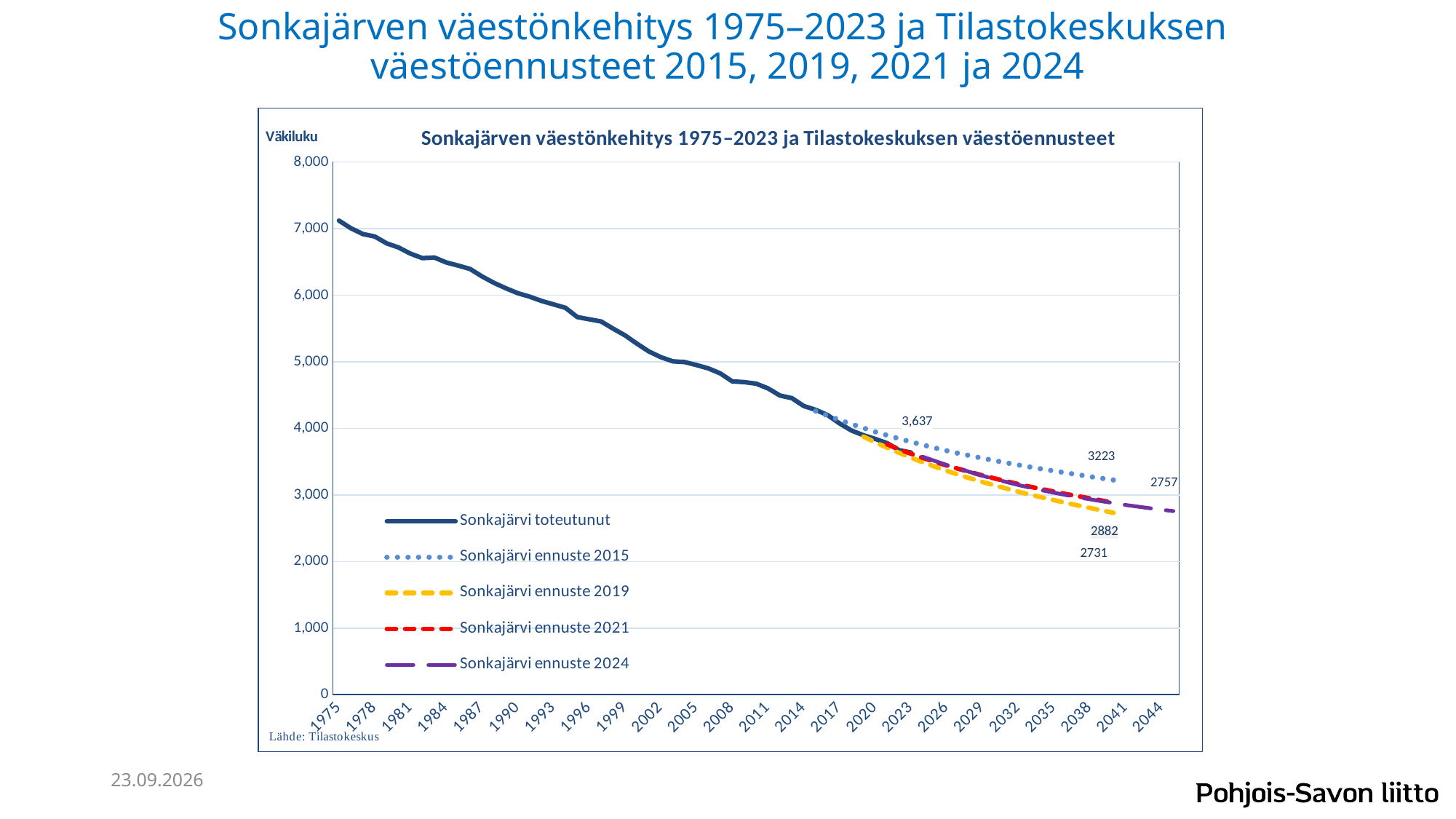
What is the final labelled value of the Sonkajärvi ennuste 2024 series? 2757 Which forecast series ends at the highest value? Sonkajärvi ennuste 2015 What is the difference between the end value of ennuste 2015 (3223) and the end value of ennuste 2024 (2757)? 466 Does the Sonkajärvi toteutunut series rise or fall from 1975 to 2023? fall What is the final labelled value of the Sonkajärvi ennuste 2015 series? 3223 Which is larger, the end value of ennuste 2015 (3223) or the end value of ennuste 2024 (2757)? ennuste 2015 How many series does the legend list? 5 Is the Sonkajärvi toteutunut value for 1975 greater or less than 7,000? greater What kind of chart is shown on the slide? line chart Is the Sonkajärvi toteutunut value for 2011 greater or less than 5,000? less What label is shown on the vertical axis of the chart? Väkiluku What data label is shown near the year 2023 on the chart? 3,637